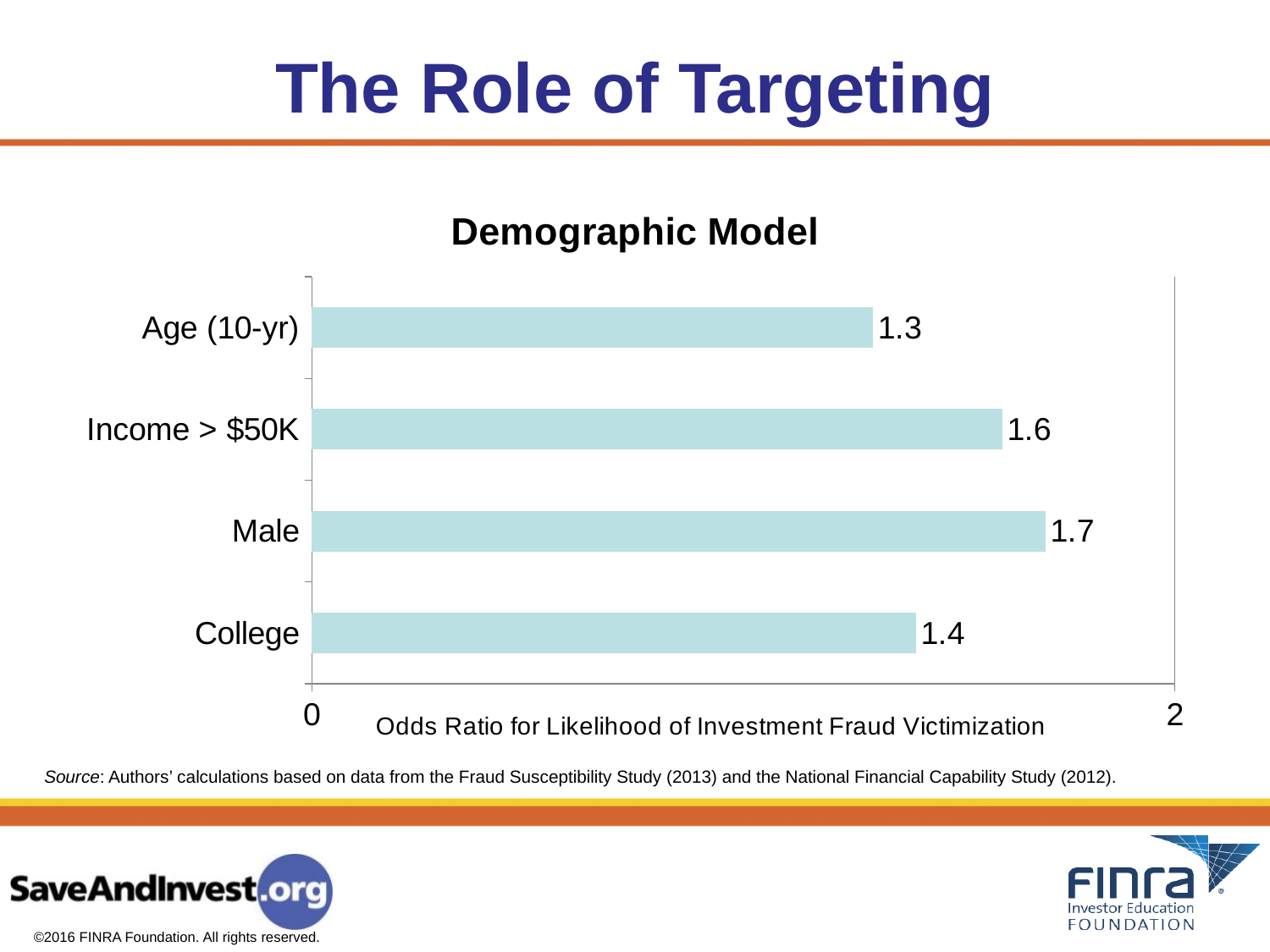
What is the label of the horizontal axis? Odds Ratio for Likelihood of Investment Fraud Victimization What is the odds ratio for College? 1.4 Which category has the highest odds ratio? Male What is the title of the chart? Demographic Model What is the odds ratio for Age (10-yr)? 1.3 What is the odds ratio for Income > $50K? 1.6 Which has a larger odds ratio, Income > $50K or College? Income > $50K What kind of chart is shown on the slide? Bar chart Which category has the lowest odds ratio? Age (10-yr) What is the odds ratio for Male? 1.7 How many categories are shown in the chart? 4 What is the difference between the odds ratios for Male and Age (10-yr)? 0.4